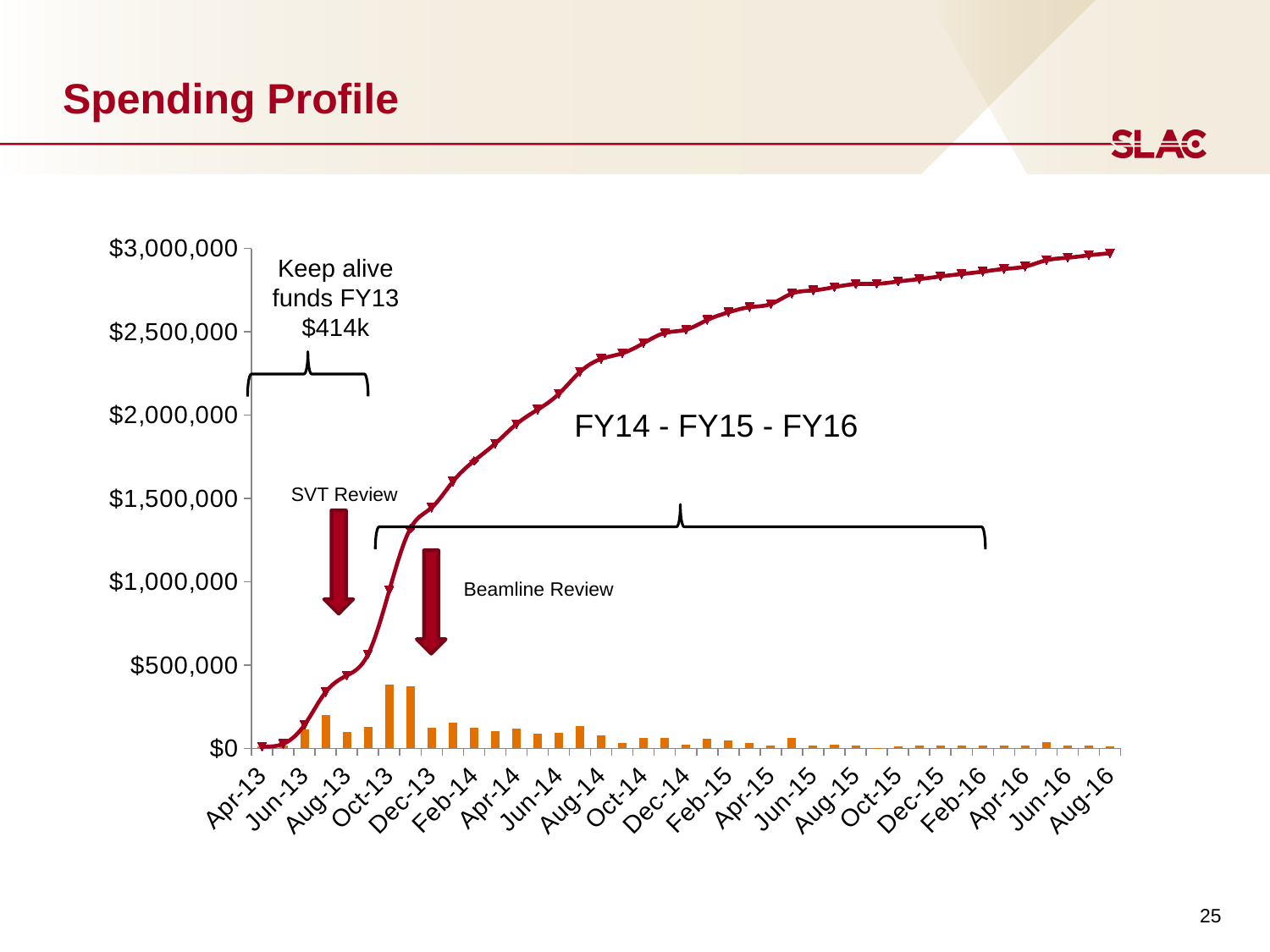
What is the title of the slide containing the chart? Spending Profile Which is larger, the red line value at Dec-13 or at Jun-13? Dec-13 Is the value of the red line at Aug-16 greater or less than $2,500,000? greater How many month labels are shown on the x axis? 21 What is the highest value shown on the y axis? $3,000,000 Is the value of the red line at Apr-14 greater or less than $1,500,000? greater Is the value of the red line at Aug-14 greater or less than $2,000,000? greater What kinds of chart are combined in this chart? A bar chart and a line chart Does the red line rise or fall from Apr-13 to Aug-16? Rises Do the orange bars generally rise or fall from Dec-13 to Aug-16? Fall